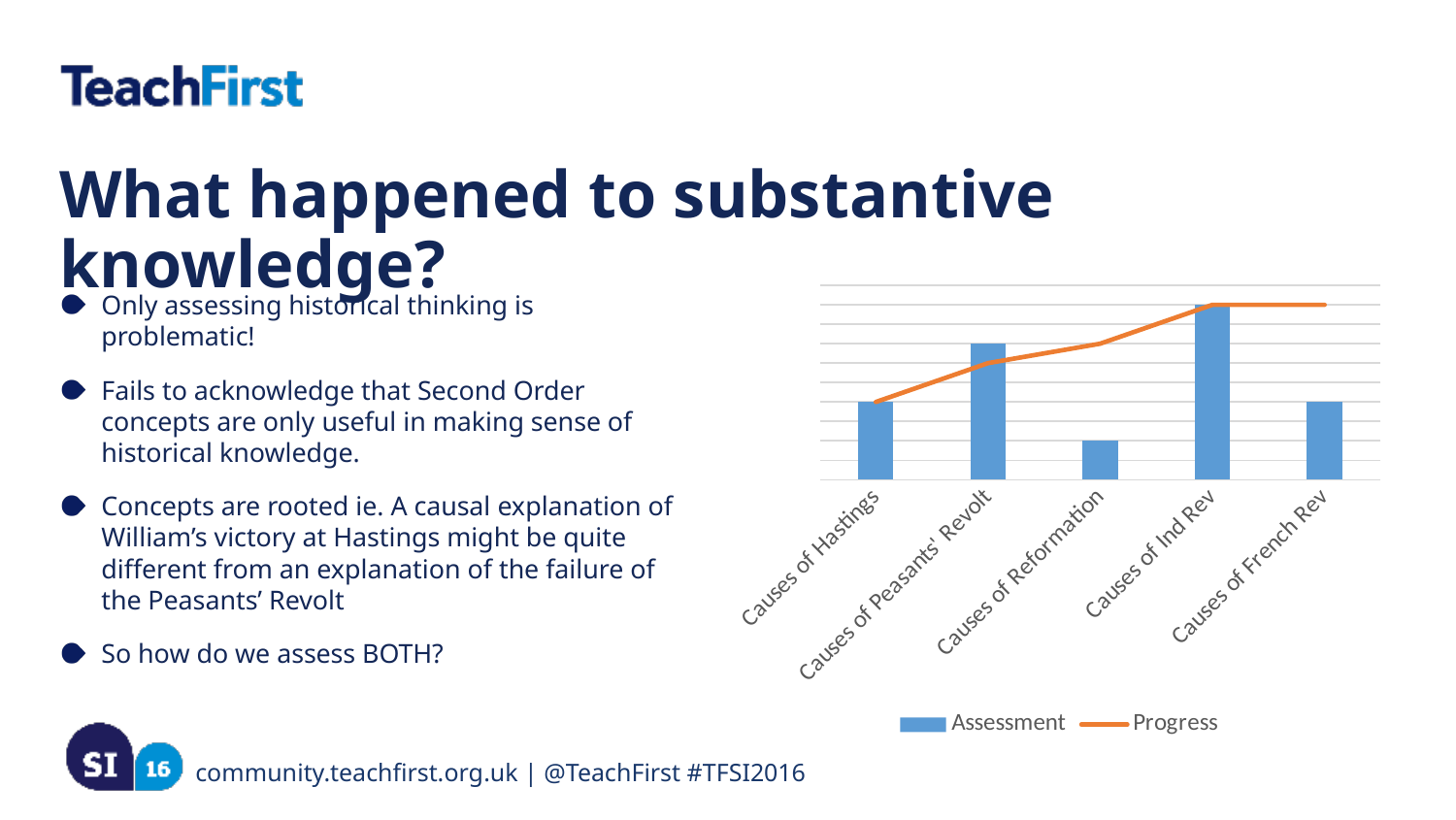
Does the Progress line generally rise or fall from Causes of Hastings to Causes of Ind Rev? rise Which series is drawn as a line rather than bars? Progress How many series does the chart legend list? 2 What kind of chart is shown on the slide? A bar chart combined with a line Which category has the highest Assessment bar? Causes of Ind Rev How many categories are shown on the x axis of the chart? 5 What are the names of the two series in the chart legend? Assessment and Progress Is the Assessment bar for Causes of Ind Rev higher or lower than the bar for Causes of French Rev? higher Is the Assessment bar for Causes of Hastings higher or lower than the bar for Causes of Peasants' Revolt? lower Is the Assessment bar for Causes of Peasants' Revolt higher or lower than the bar for Causes of Reformation? higher Which category has the lowest Assessment bar? Causes of Reformation Which category is the first one on the x axis of the chart? Causes of Hastings